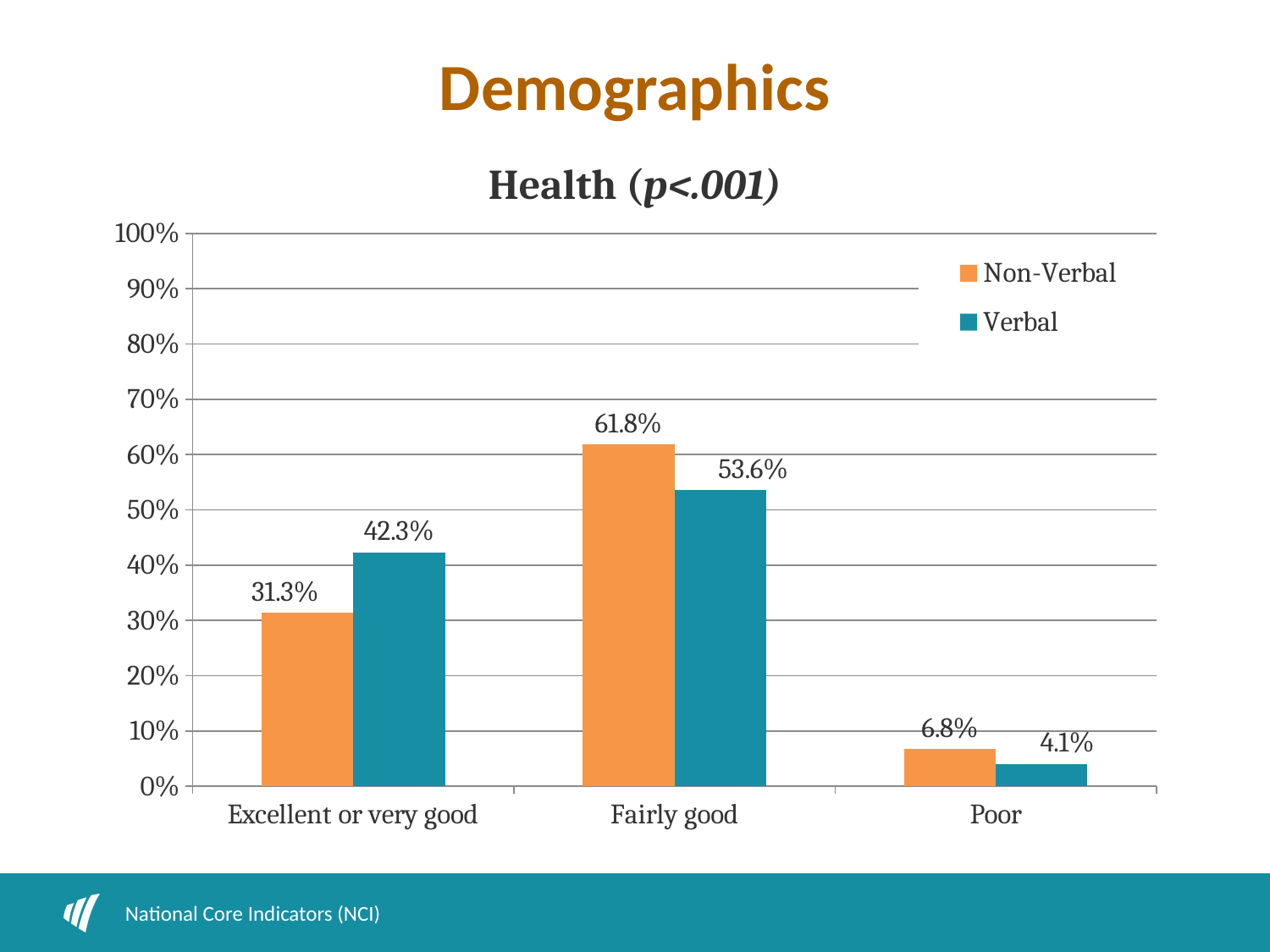
What is the Verbal value for Poor? 4.1% How many series does the legend list? 2 What is the difference between the Verbal and Non-Verbal values for Excellent or very good? 11.0% Which category has the highest Non-Verbal value? Fairly good What kind of chart is shown on the slide? Bar chart What is the difference between the Non-Verbal and Verbal values for Fairly good? 8.2% Is the Non-Verbal value for Excellent or very good greater or less than 40%? less For Poor, which series has the larger value, Non-Verbal or Verbal? Non-Verbal How many categories are shown on the x axis? 3 What is the Verbal value for Excellent or very good? 42.3% Which category has the lowest Verbal value? Poor What is the Non-Verbal value for Fairly good? 61.8%